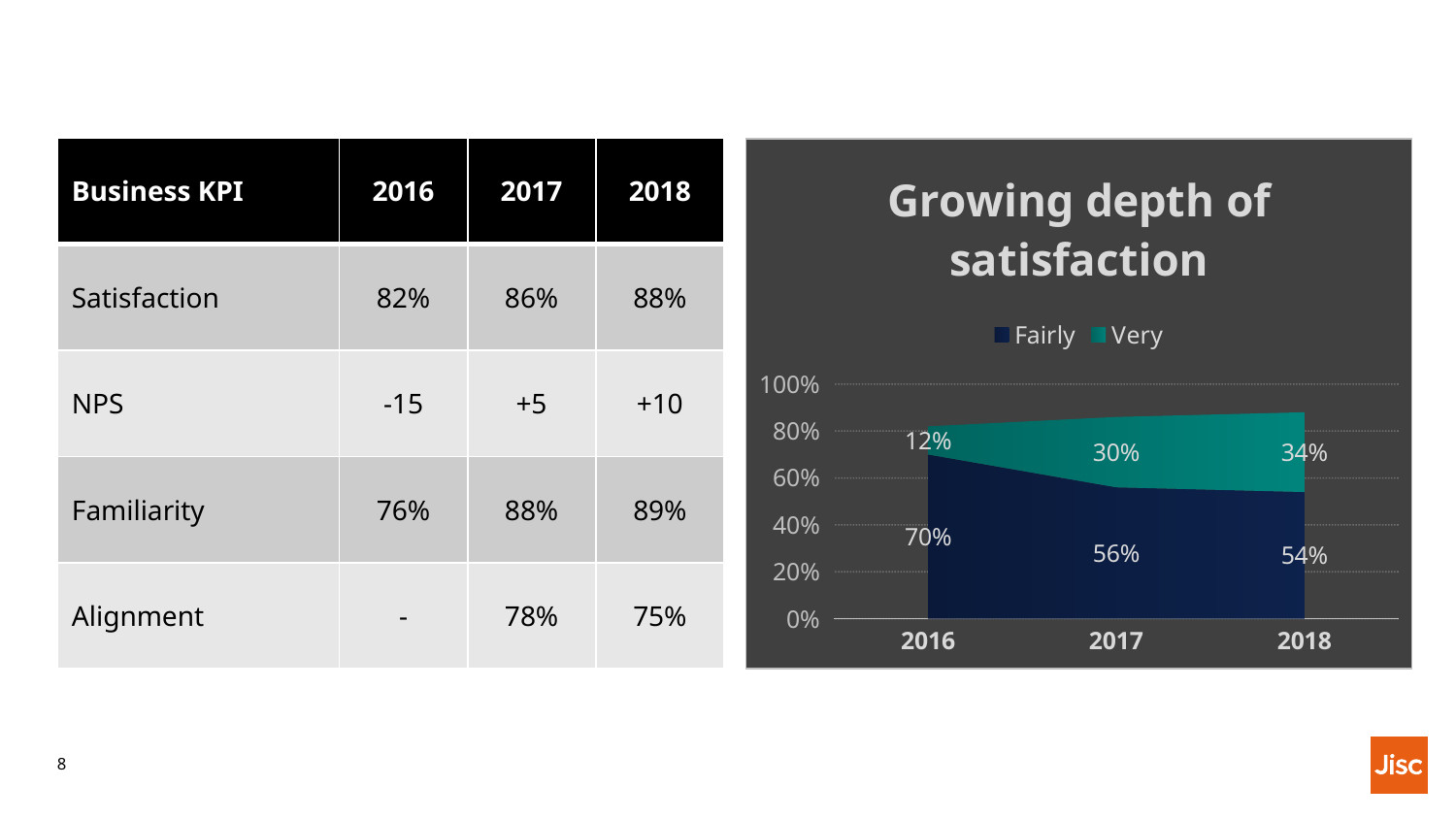
How many series does the chart legend list? 2 In which year is the Very series highest? 2018 What is the value for Fairly in 2018? 54% What is the value for Fairly in 2016? 70% What kind of chart is shown on the slide? Stacked area chart In which year is the Fairly series lowest? 2018 What is the combined total of Fairly and Very in 2017? 86% What is the value for Very in 2018? 34% What is the difference between the Very values for 2018 and 2016? 22% What is the value for Very in 2017? 30% How many years are shown on the x axis of the chart? 3 Which is larger in 2017, Fairly or Very? Fairly